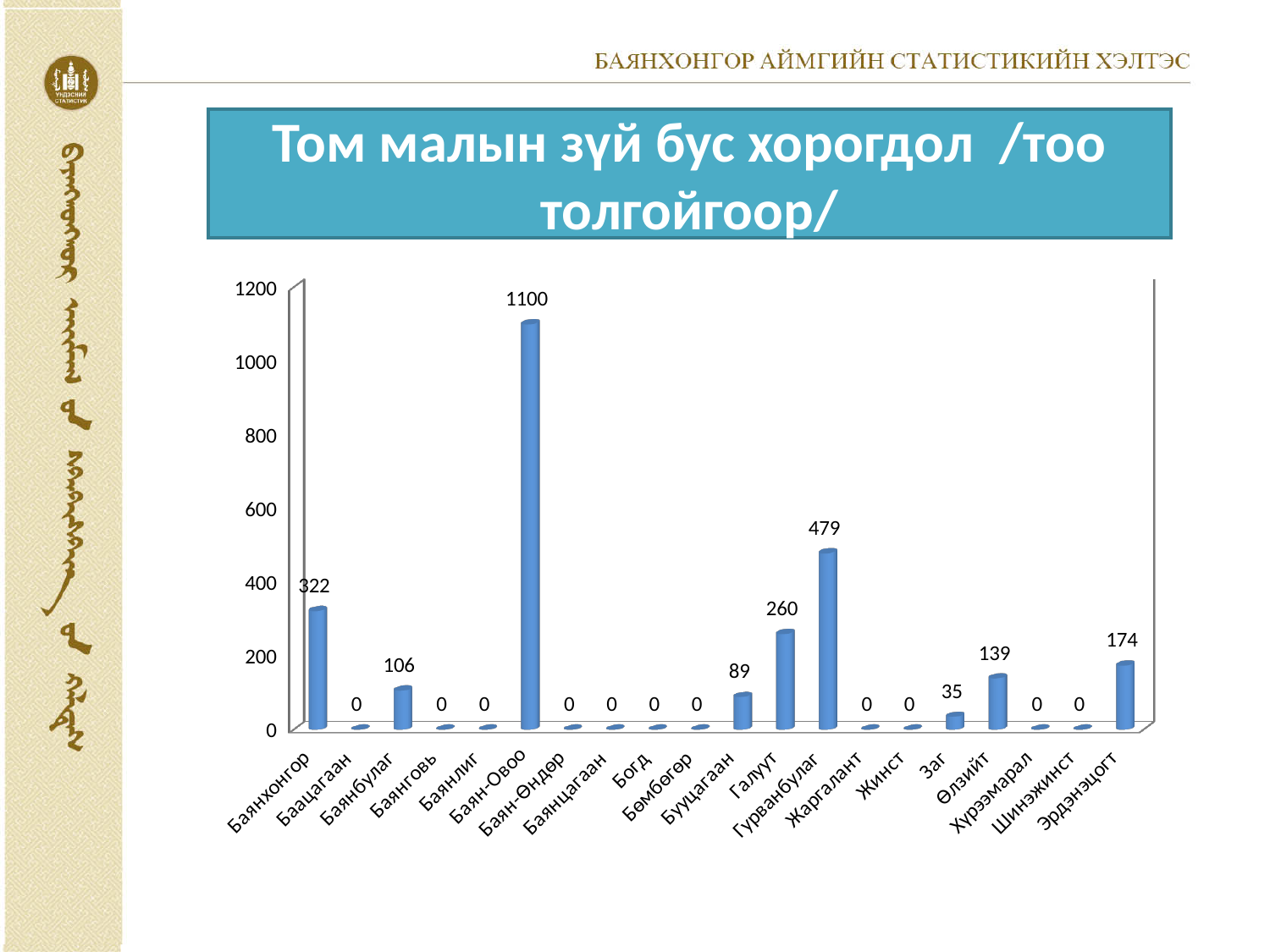
What is the value for Гурванбулаг? 479 Is the value for Баянхонгор greater or less than 400? less How many categories are shown on the x axis? 20 What is the value for Эрдэнэцогт? 174 How many categories have a value of 0? 11 Which category has the highest value? Баян-Овоо What is the value for Баян-Овоо? 1100 What is the difference between the values for Баянхонгор and Галуут? 62 What is the difference between the values for Гурванбулаг and Өлзийт? 340 What is the value for Заг? 35 Which is larger, the value for Баянбулаг or the value for Буцагаан? Баянбулаг What kind of chart is shown on the slide? Bar chart